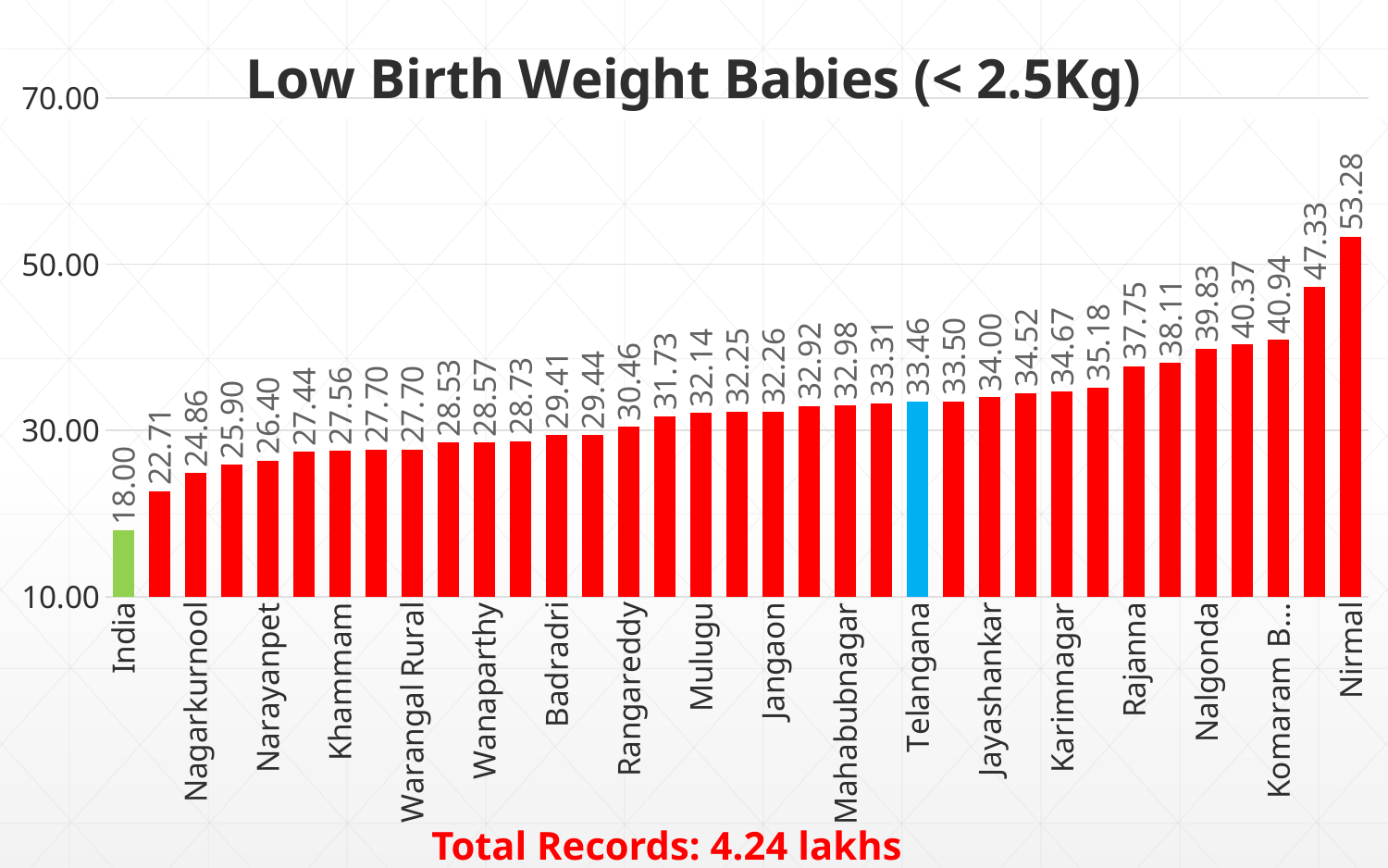
Which category has the lowest value? India Which is larger, the value for Rajanna or the value for Khammam? Rajanna What is the value for India? 18.00 Do the values rise or fall from left to right along the x axis? rise Is the value for Karimnagar greater or less than 30.00? greater What is the value for Nirmal? 53.28 What is the value for Telangana? 33.46 What is the value for Nalgonda? 39.83 Which category has the highest value? Nirmal What is the title of the chart? Low Birth Weight Babies (< 2.5Kg) What is the difference between the values for Nirmal and India? 35.28 What kind of chart is shown on the slide? bar chart